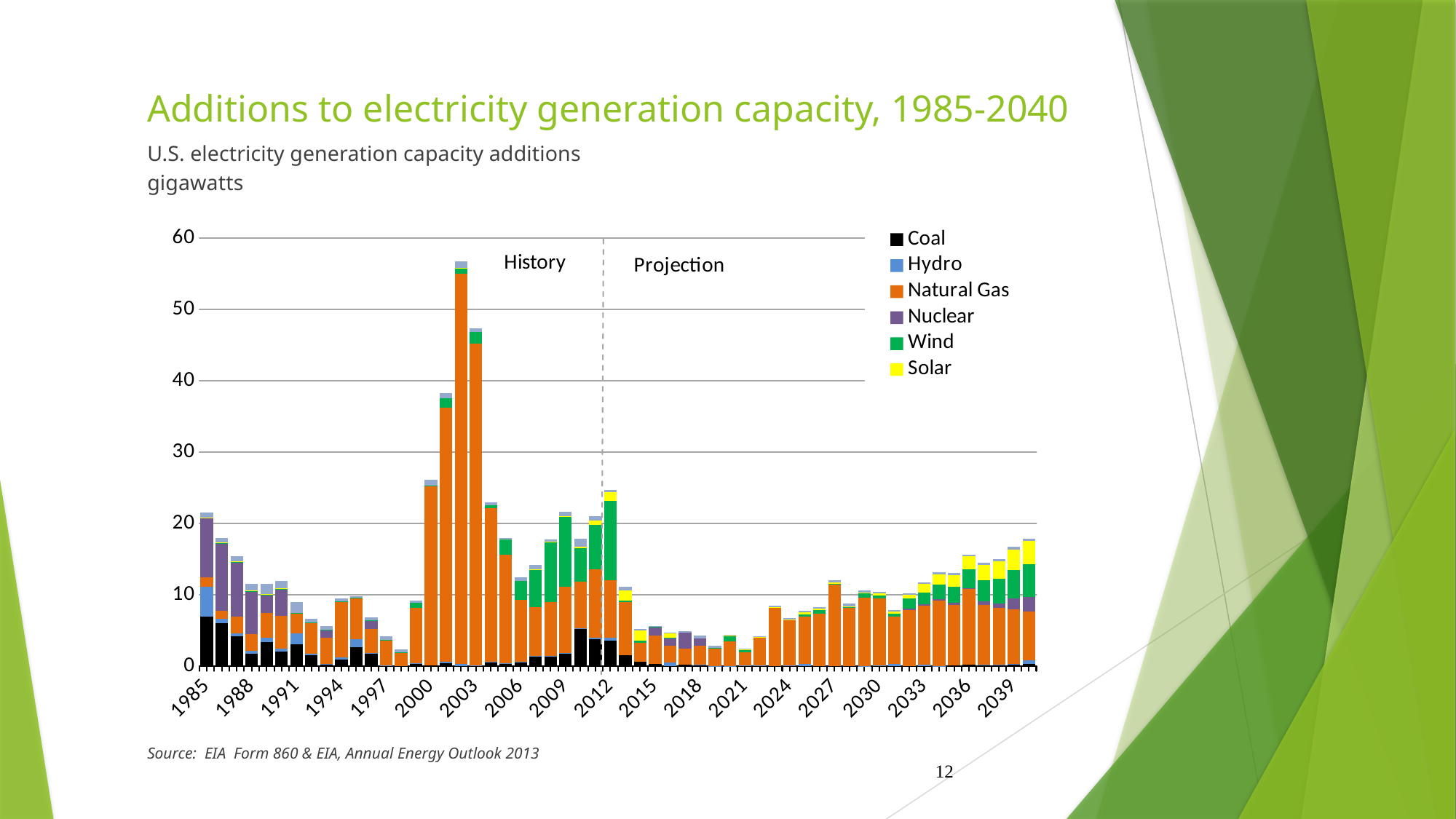
Is the total value for 2021 greater or less than 10? less Which year has the tallest bar (largest total capacity additions)? 2002 Which year has the larger total, 2002 or 2003? 2002 Is the total value for 2003 greater or less than 40? greater Is the total value for 1985 greater or less than 20? greater What kind of chart is shown on the slide? Stacked bar chart Do the total capacity additions generally rise or fall from 2021 to 2040? rise Which series is shown in yellow in the legend? Solar How many series does the legend list? 6 What two periods does the dashed vertical line separate? History and Projection